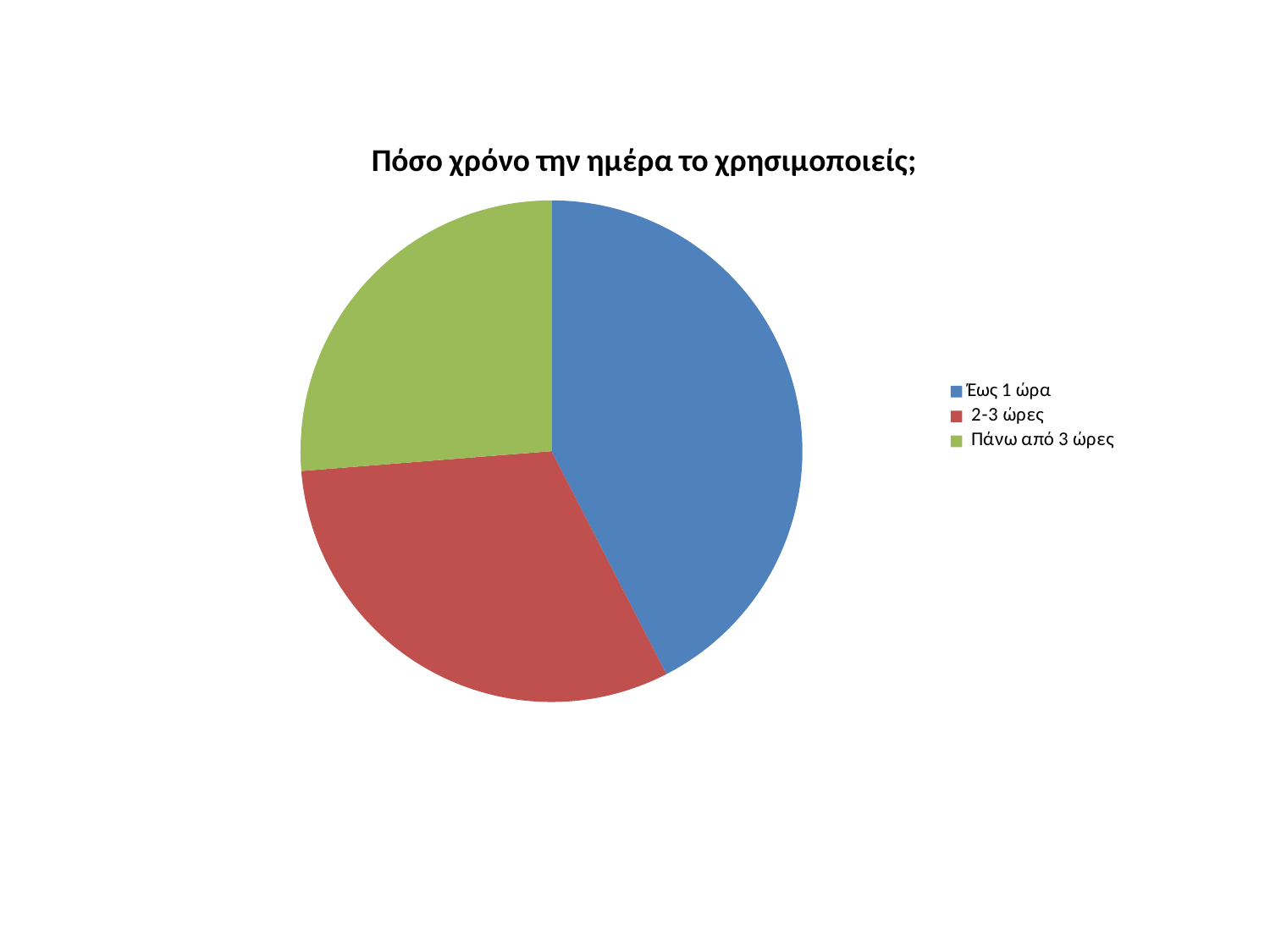
Which slice is larger, 2-3 ώρες or Πάνω από 3 ώρες? 2-3 ώρες Which colour represents the category 2-3 ώρες in the pie chart? red Which slice is larger, Έως 1 ώρα or 2-3 ώρες? Έως 1 ώρα Which category has the smallest slice of the pie? Πάνω από 3 ώρες Which category has the largest slice of the pie? Έως 1 ώρα How many slices does the pie chart have? 3 How many entries does the legend list? 3 Which slice is larger, Έως 1 ώρα or Πάνω από 3 ώρες? Έως 1 ώρα What is the title of the chart? Πόσο χρόνο την ημέρα το χρησιμοποιείς; What kind of chart is shown on the slide? pie chart